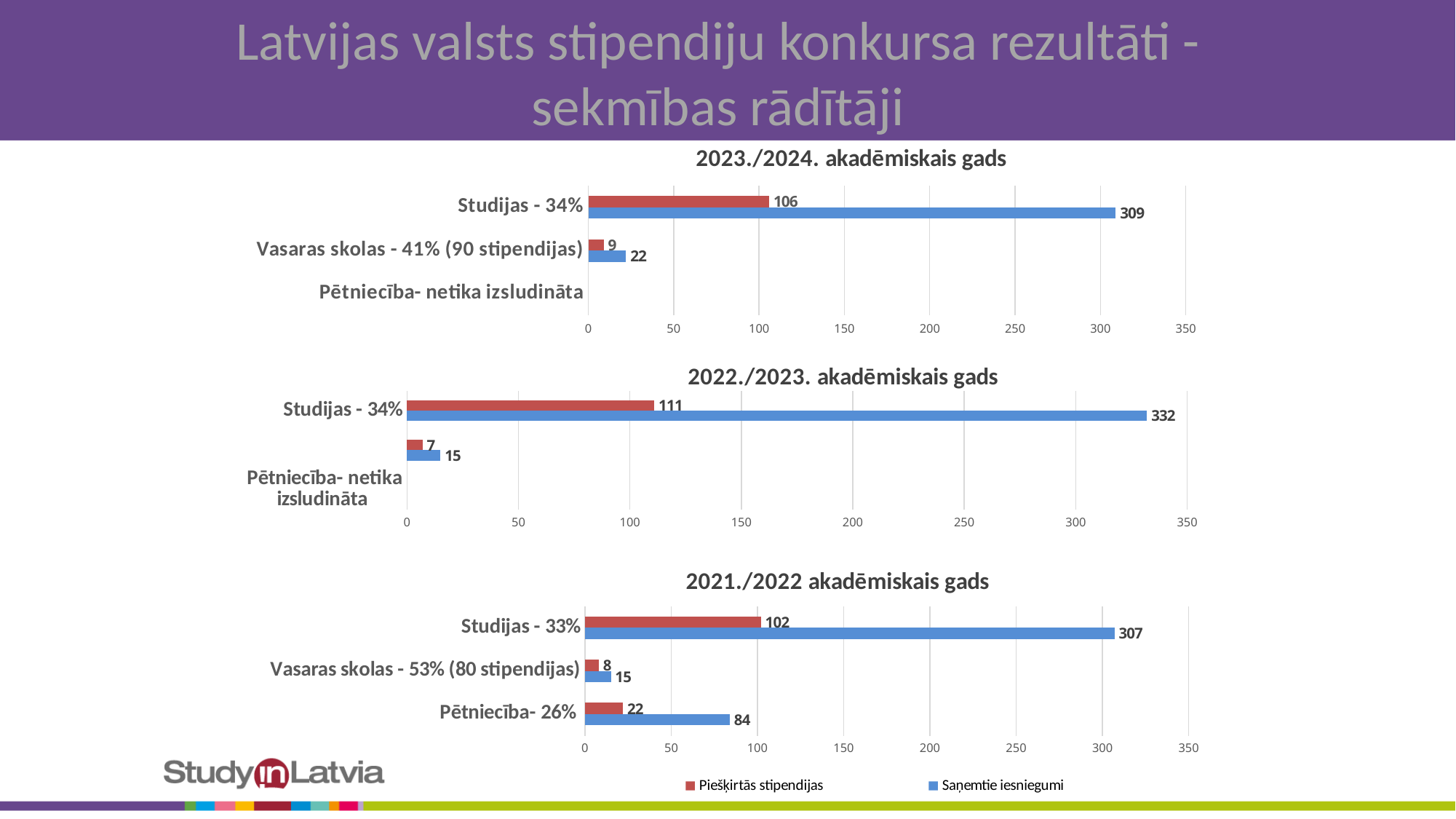
In the 2022./2023. akadēmiskais gads chart, is the Saņemtie iesniegumi value for Studijas - 34% greater or less than 300? greater In the 2023./2024. akadēmiskais gads chart, what is the value of Saņemtie iesniegumi for Studijas - 34%? 309 In the 2023./2024. akadēmiskais gads chart, what is the value of Piešķirtās stipendijas for Vasaras skolas - 41% (90 stipendijas)? 9 In the 2021./2022 akadēmiskais gads chart, what is the value of Saņemtie iesniegumi for Pētniecība- 26%? 84 In the 2021./2022 akadēmiskais gads chart, what is the difference between Saņemtie iesniegumi and Piešķirtās stipendijas for Pētniecība- 26%? 62 In the 2021./2022 akadēmiskais gads chart, which category has the highest Saņemtie iesniegumi value? Studijas - 33% In the 2021./2022 akadēmiskais gads chart, which category has the lowest Piešķirtās stipendijas value? Vasaras skolas - 53% (80 stipendijas) In the 2021./2022 akadēmiskais gads chart, which is larger: Piešķirtās stipendijas for Pētniecība- 26% or Piešķirtās stipendijas for Vasaras skolas - 53% (80 stipendijas)? Pētniecība- 26% In the 2023./2024. akadēmiskais gads chart, what is the difference between Saņemtie iesniegumi and Piešķirtās stipendijas for Studijas - 34%? 203 In the 2022./2023. akadēmiskais gads chart, what is the value of Piešķirtās stipendijas for Studijas - 34%? 111 What type of chart is the 2023./2024. akadēmiskais gads chart? Bar chart How many series does the legend at the bottom of the slide list? 2